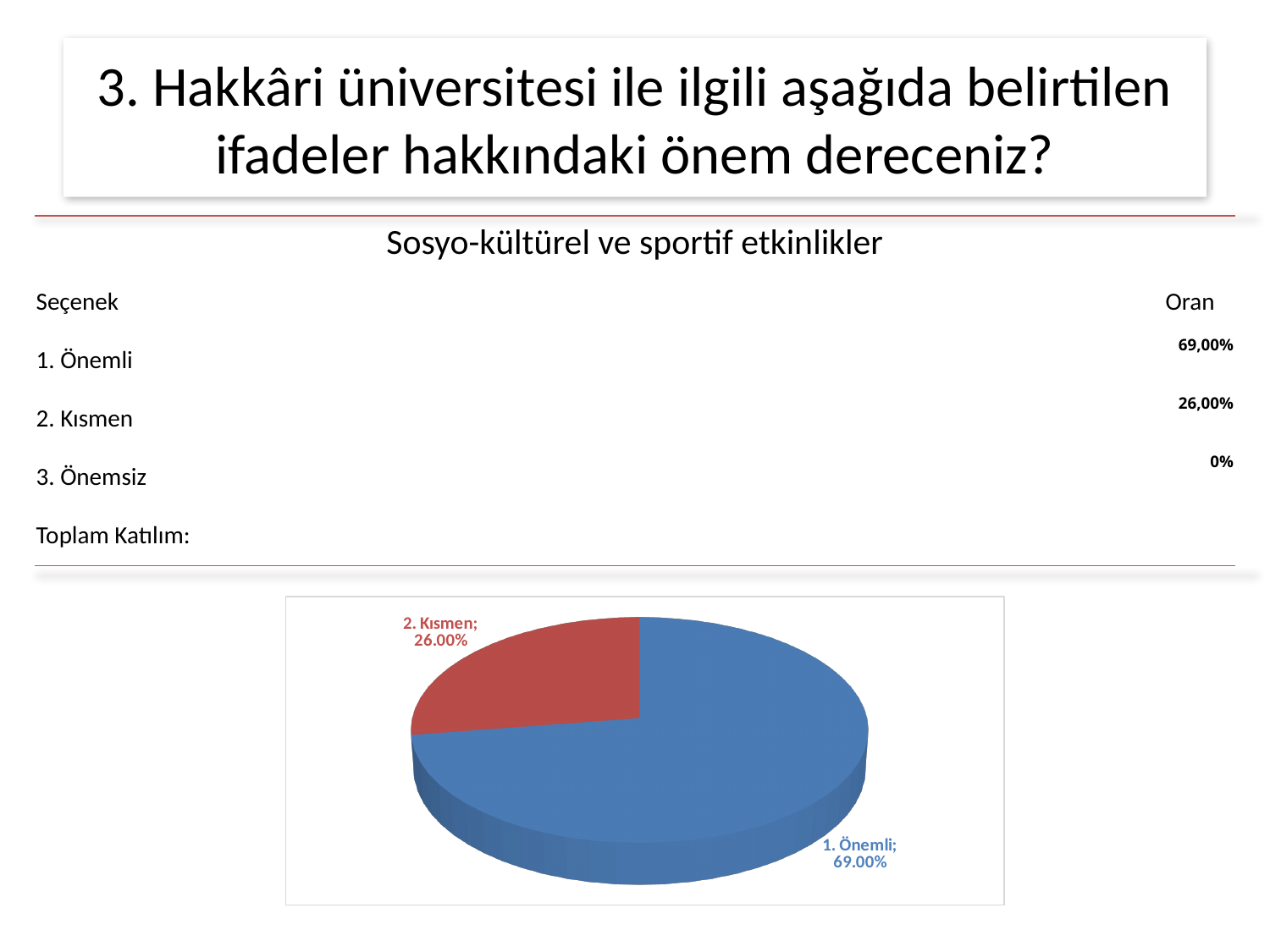
What colour is the "1. Önemli" slice in the pie chart? blue Which labelled slice of the pie chart is the smallest? 2. Kısmen What percentage is shown for the "2. Kısmen" slice of the pie chart? 26.00% Which slice of the pie chart is the largest? 1. Önemli What kind of chart is shown on the slide? pie chart What percentage is shown for the "1. Önemli" slice of the pie chart? 69.00% By how many percentage points does the "1. Önemli" slice exceed the "2. Kısmen" slice in the pie chart? 43.00 What colour is the "2. Kısmen" slice in the pie chart? red How many labelled slices does the pie chart show? 2 Which slice is larger in the pie chart, "1. Önemli" or "2. Kısmen"? 1. Önemli What share of the pie does the "2. Kısmen" slice represent? 26.00%